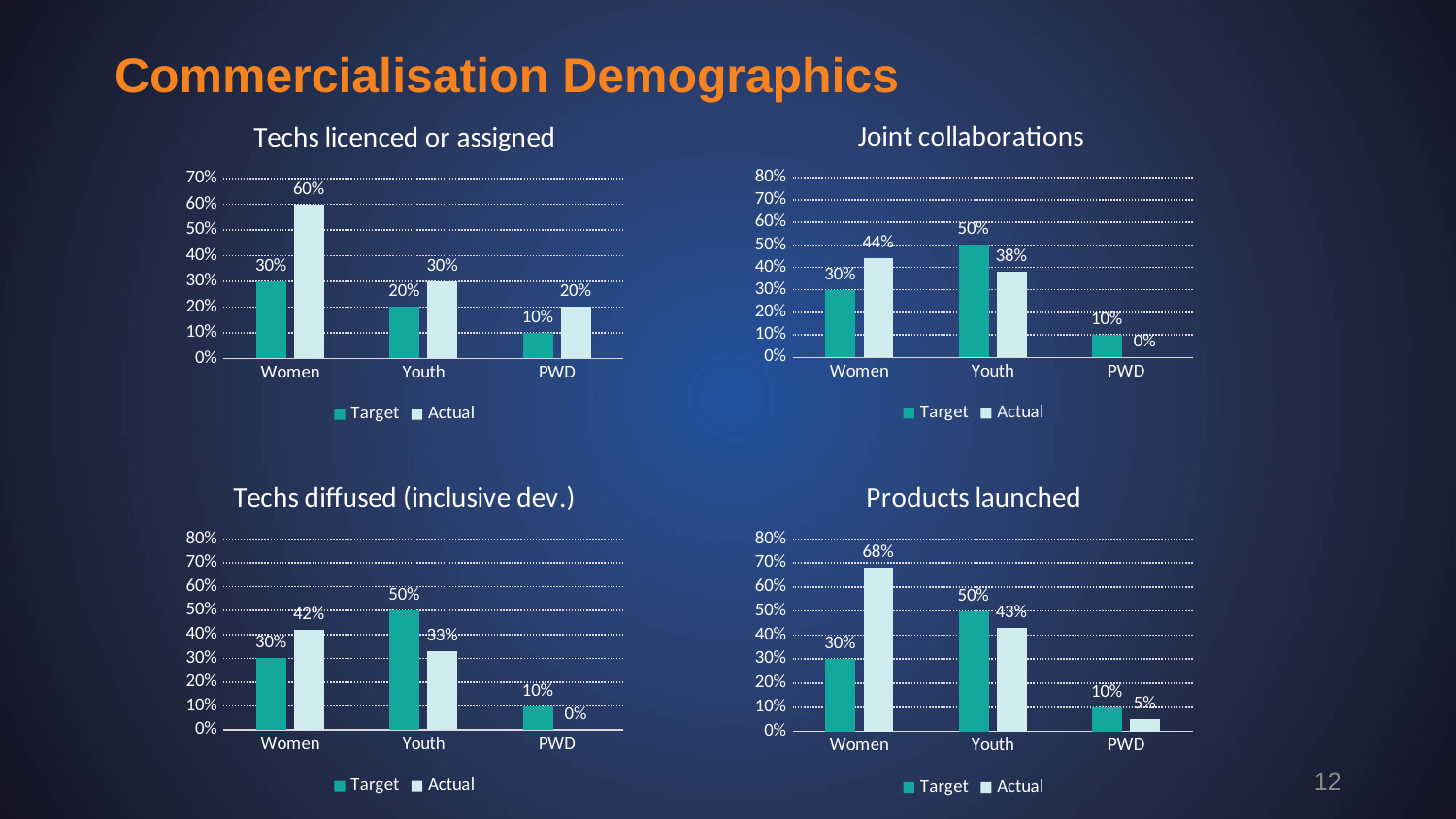
In the 'Products launched' chart, what is the Actual value for PWD? 5% What kind of chart is 'Products launched'? bar chart In the 'Techs licenced or assigned' chart, what is the Actual value for Women? 60% How many series does the legend of the 'Joint collaborations' chart list? 2 In the 'Techs licenced or assigned' chart, do the Target values rise or fall from Women to PWD? fall In the 'Joint collaborations' chart, which category has the lowest Actual value? PWD How many categories are shown on the x axis of the 'Techs licenced or assigned' chart? 3 In the 'Techs diffused (inclusive dev.)' chart, is the Target value for Youth larger or smaller than the Actual value for Youth? larger In the 'Products launched' chart, what is the difference between the Actual and Target values for Women? 38% In the 'Joint collaborations' chart, what is the Actual value for Youth? 38% What are the two legend entries in the 'Techs diffused (inclusive dev.)' chart? Target and Actual In the 'Techs diffused (inclusive dev.)' chart, which category has the highest Actual value? Women